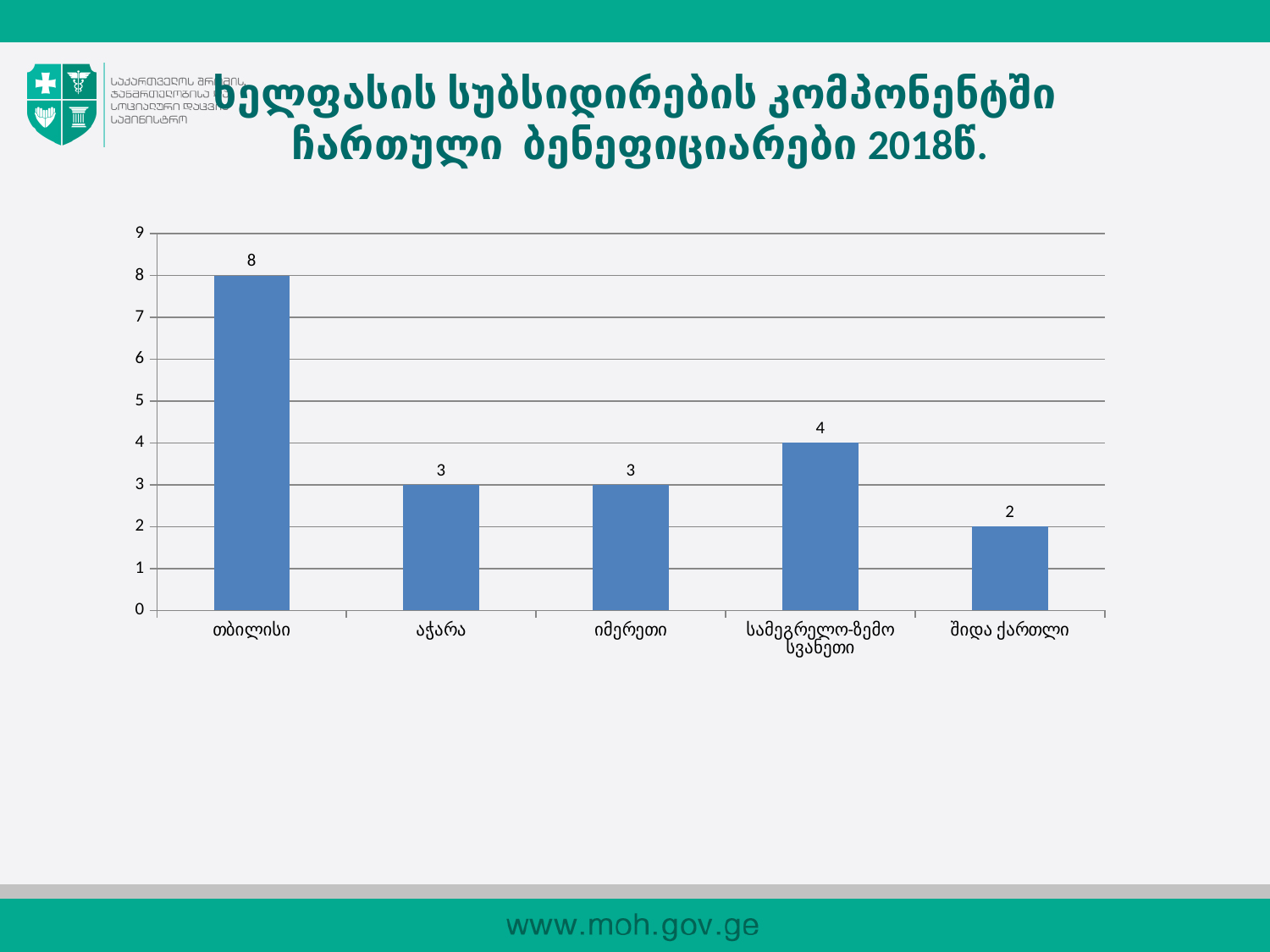
What kind of chart is shown on the slide? bar chart What is the value for თბილისი? 8 Which is larger, the value for სამეგრელო-ზემო სვანეთი or the value for იმერეთი? სამეგრელო-ზემო სვანეთი Which category has the highest value? თბილისი Is the value for თბილისი greater or less than 5? greater What is the difference between the values for იმერეთი and შიდა ქართლი? 1 What is the difference between the values for თბილისი and სამეგრელო-ზემო სვანეთი? 4 What is the value for სამეგრელო-ზემო სვანეთი? 4 How many categories are shown on the x axis? 5 What is the value for შიდა ქართლი? 2 What is the value for აჭარა? 3 Which category has the lowest value? შიდა ქართლი